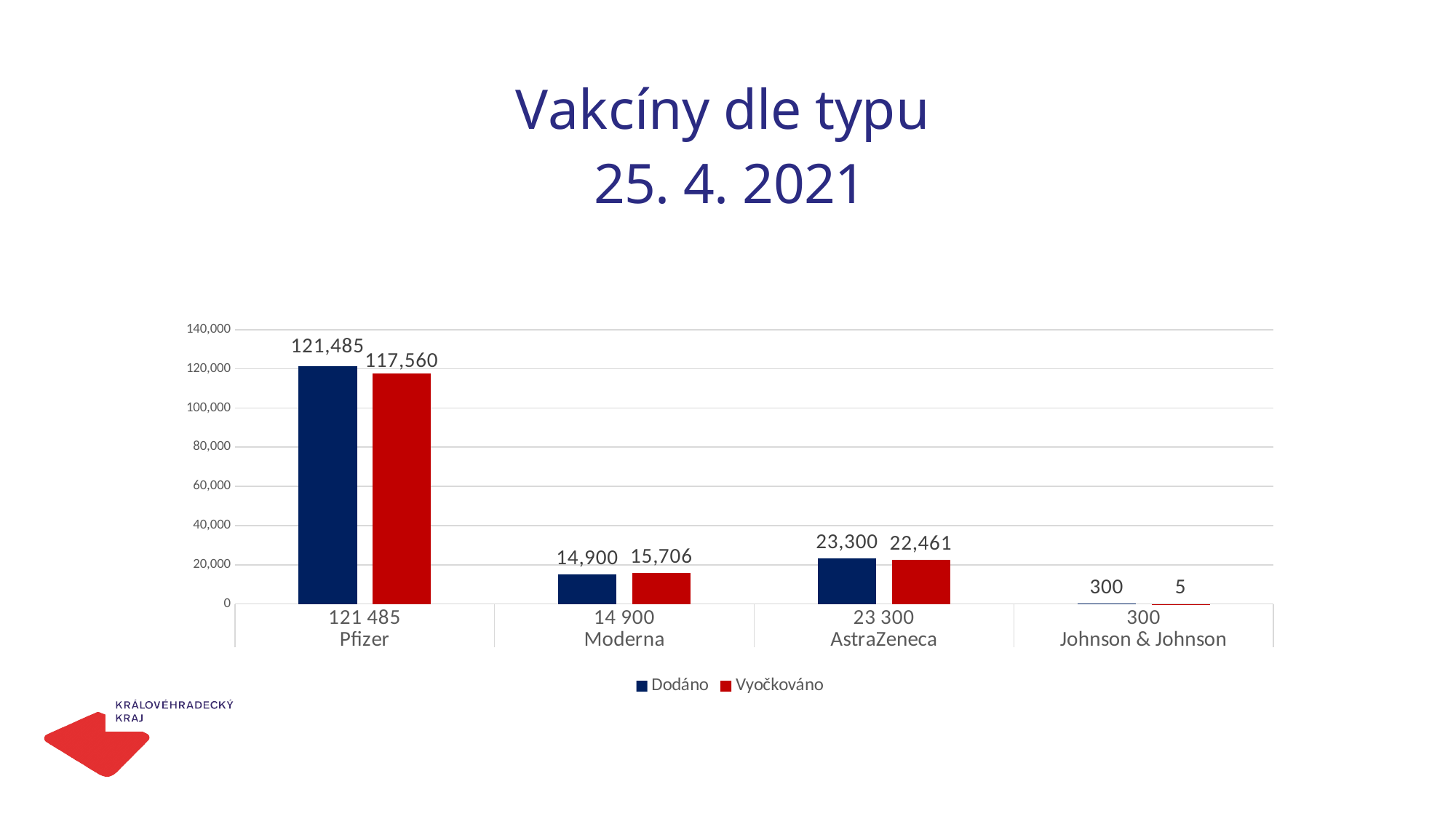
Which vaccine type has the highest Dodáno value? Pfizer What is the Dodáno value for AstraZeneca? 23,300 What kind of chart is shown on the slide? bar chart What is the Vyočkováno value for Johnson & Johnson? 5 How many series does the legend list? 2 What is the difference between the Dodáno and Vyočkováno values for Pfizer? 3,925 What is the Dodáno value for Pfizer? 121,485 How many vaccine types are shown on the x axis? 4 Which is larger for Moderna, the Dodáno value or the Vyočkováno value? Vyočkováno What is the Vyočkováno value for Moderna? 15,706 Is the Vyočkováno value for AstraZeneca greater or less than 20,000? greater Which vaccine type has the lowest Vyočkováno value? Johnson & Johnson